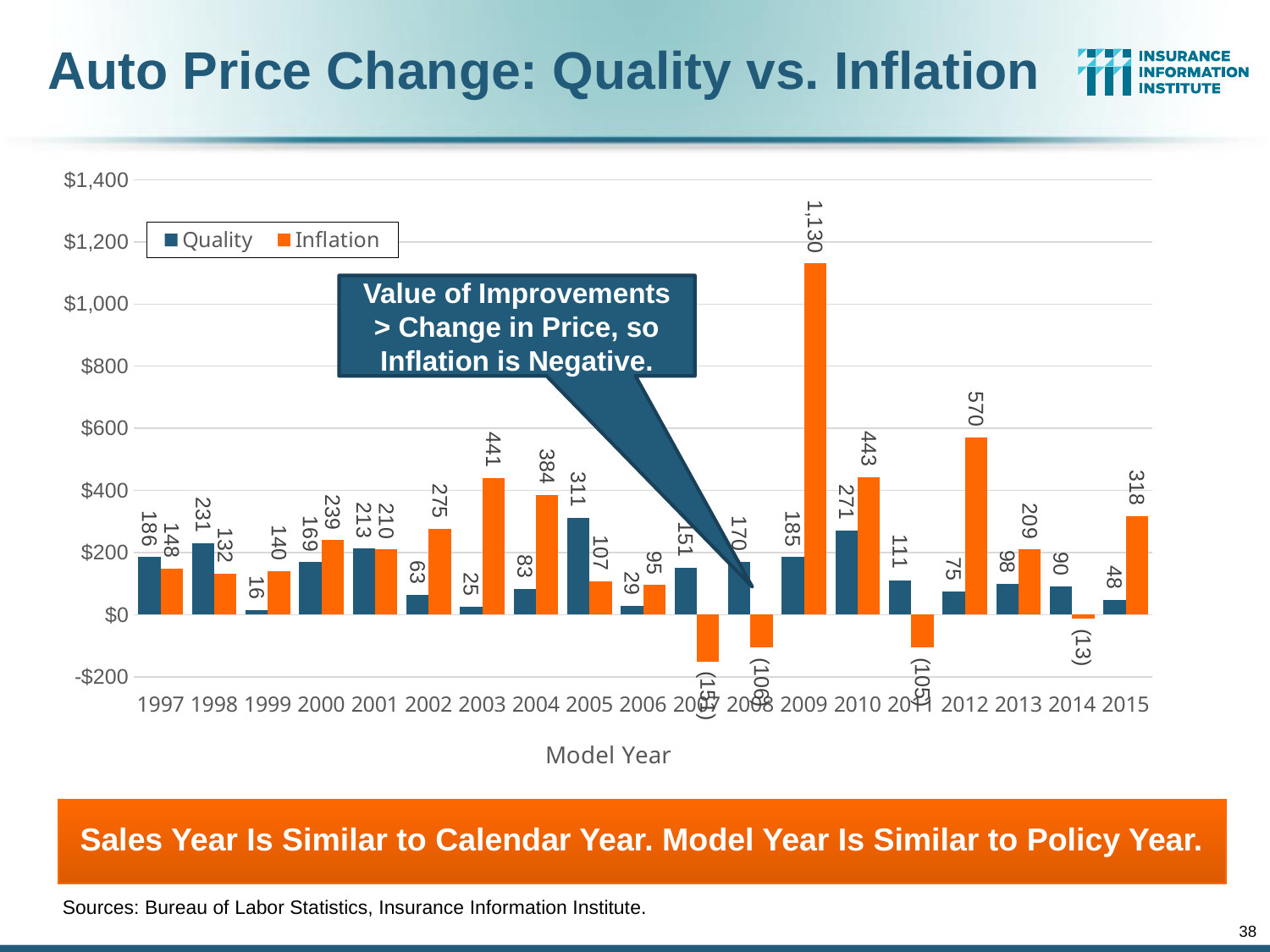
Which is larger for model year 2003, the Quality value or the Inflation value? Inflation What kind of chart is shown on the slide? Bar chart What is the title of the slide's chart? Auto Price Change: Quality vs. Inflation How many series does the legend list? 2 Is the Inflation value for model year 2009 greater or less than $1,000? greater Which model year has the highest Inflation value? 2009 How many model years are shown on the x axis? 19 What is the difference between the Inflation value and the Quality value for model year 2012? 495 What is the Quality value for model year 2005? 311 What is the Inflation value for model year 2009? 1,130 What is the Inflation value for model year 2014? (13) Which model year has the lowest Quality value? 1999